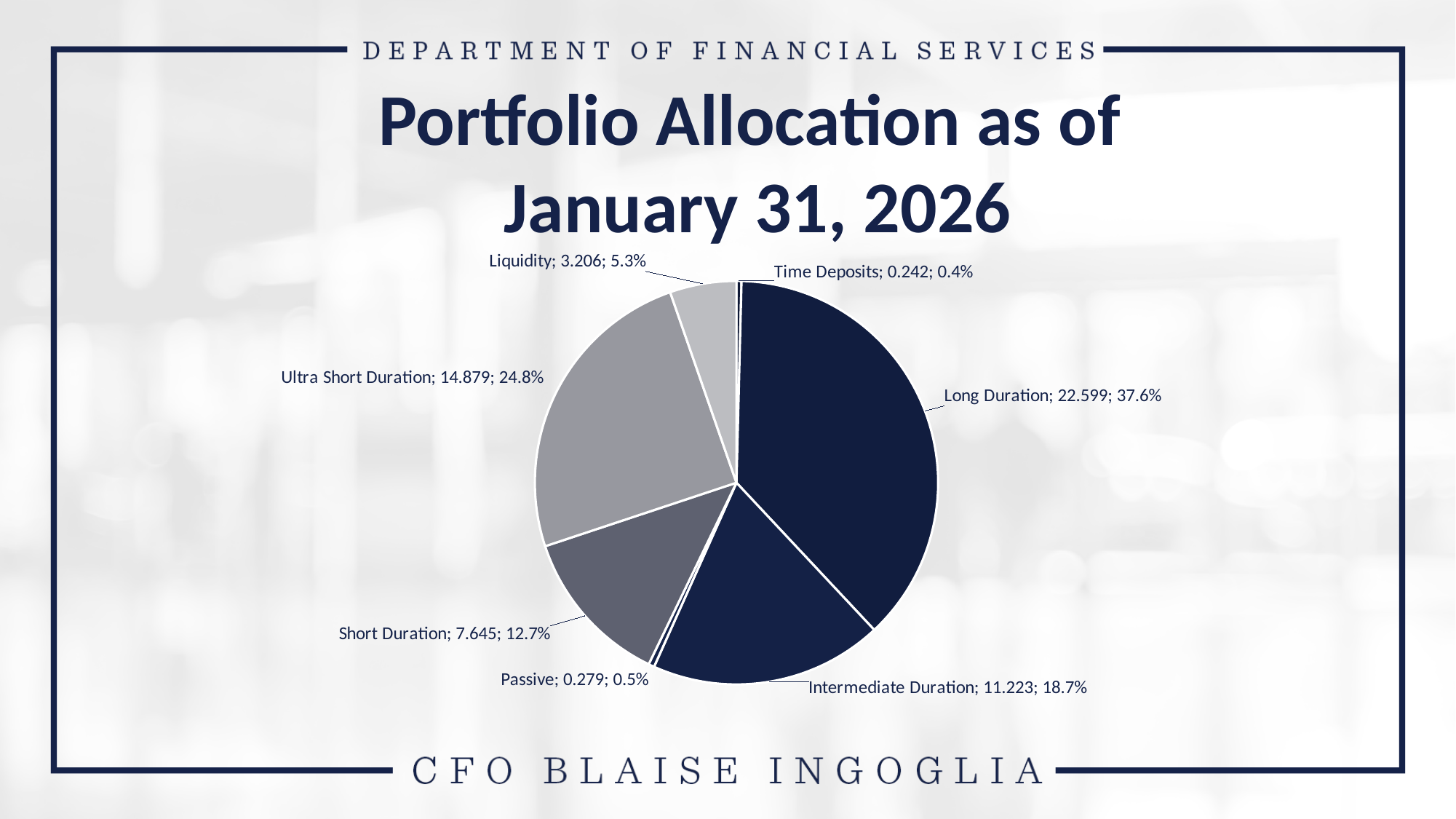
What share of the pie does Ultra Short Duration represent? 24.8% What share of the pie does Liquidity represent? 5.3% Which category has the largest slice? Long Duration Which category has the smallest slice? Time Deposits What is the value for Long Duration? 22.599 What is the value for Passive? 0.279 Which is larger, Short Duration or Ultra Short Duration? Ultra Short Duration What is the title of the chart? Portfolio Allocation as of January 31, 2026 What type of chart is shown on the slide? pie chart What is the difference between the values for Long Duration and Intermediate Duration? 11.376 How many categories are shown in the pie chart? 7 What is the value for Intermediate Duration? 11.223